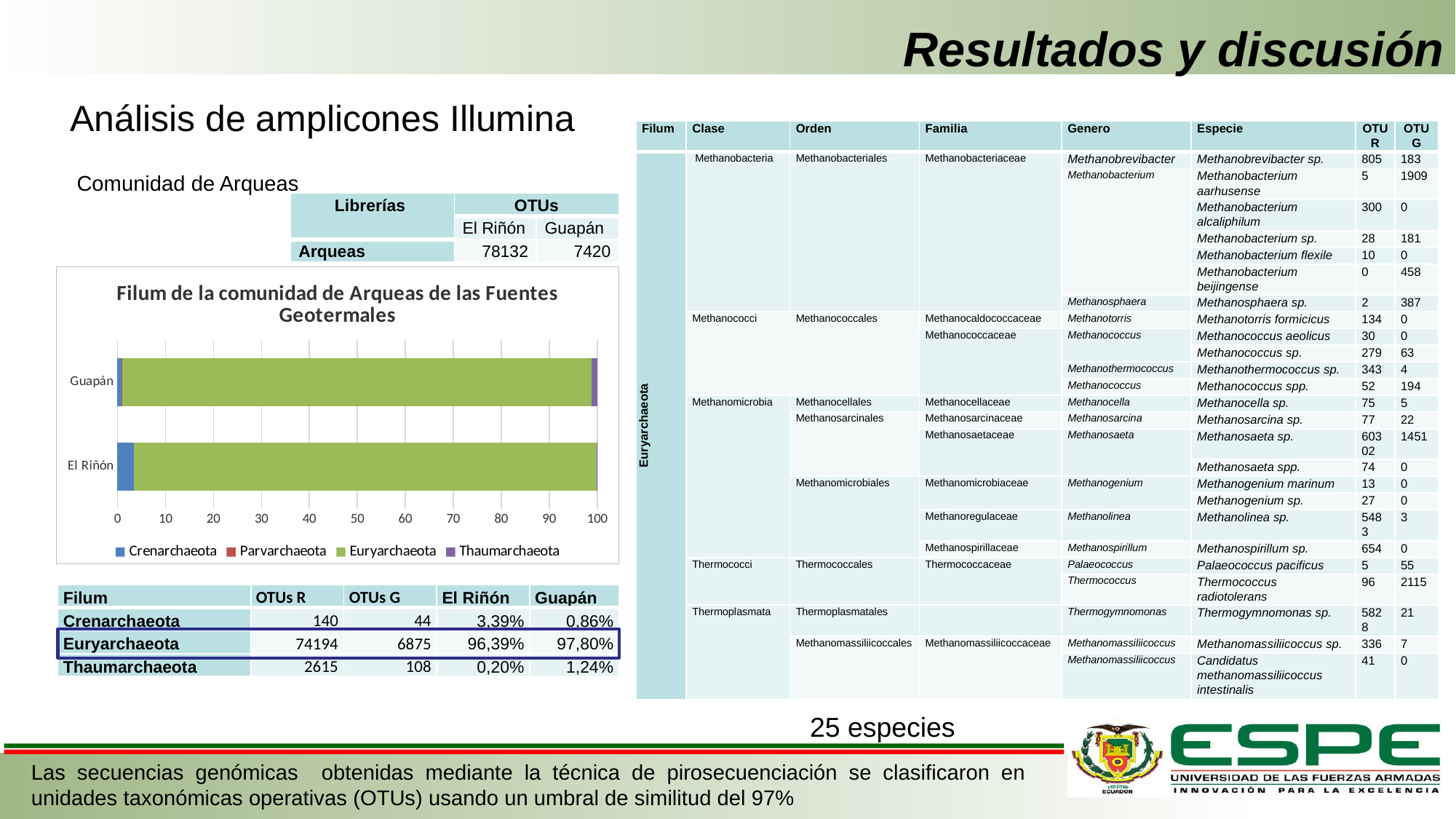
What is the title of the bar chart? Filum de la comunidad de Arqueas de las Fuentes Geotermales Which site has the larger Crenarchaeota segment, El Riñón or Guapán? El Riñón Which site has the larger Thaumarchaeota segment, El Riñón or Guapán? Guapán What is the highest tick value shown on the chart's x axis? 100 What kind of chart is shown under the title 'Filum de la comunidad de Arqueas de las Fuentes Geotermales'? bar chart Which series is listed last in the chart's legend? Thaumarchaeota Is the Crenarchaeota value for El Riñón greater or less than 10? less How many series does the chart's legend list? 4 Is the Euryarchaeota value for El Riñón greater or less than 50? greater Which series makes up the largest segment of the Guapán bar? Euryarchaeota Is the Euryarchaeota value for Guapán greater or less than 90? greater How many categories (sites) are plotted on the y axis of the chart? 2